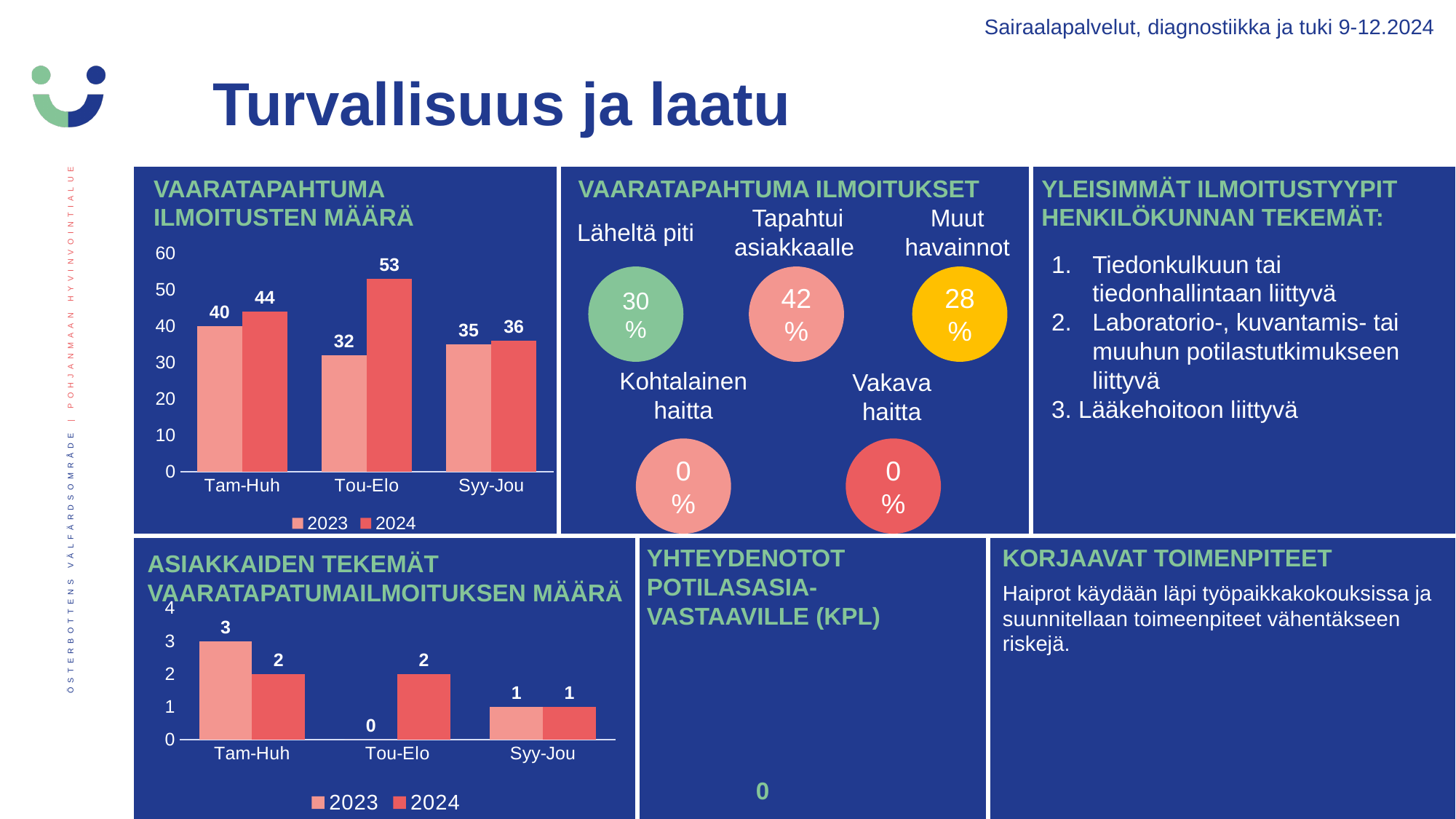
In the chart titled VAARATAPAHTUMA ILMOITUSTEN MÄÄRÄ, which is larger in Tam-Huh: the 2023 value or the 2024 value? 2024 In the chart titled VAARATAPAHTUMA ILMOITUSTEN MÄÄRÄ, which period has the highest 2024 value? Tou-Elo In the chart titled VAARATAPAHTUMA ILMOITUSTEN MÄÄRÄ, how many series does the legend list? 2 In the chart titled VAARATAPAHTUMA ILMOITUSTEN MÄÄRÄ, what is the value for 2023 in Syy-Jou? 35 In the chart titled VAARATAPAHTUMA ILMOITUSTEN MÄÄRÄ, which period has the lowest 2023 value? Tou-Elo In the chart titled ASIAKKAIDEN TEKEMÄT VAARATAPATUMAILMOITUKSEN MÄÄRÄ, what is the value for 2023 in Tam-Huh? 3 In the chart titled ASIAKKAIDEN TEKEMÄT VAARATAPATUMAILMOITUKSEN MÄÄRÄ, how many periods are shown on the x axis? 3 In the chart titled ASIAKKAIDEN TEKEMÄT VAARATAPATUMAILMOITUKSEN MÄÄRÄ, do the 2023 values rise or fall from Tam-Huh to Tou-Elo? Fall In the chart titled ASIAKKAIDEN TEKEMÄT VAARATAPATUMAILMOITUKSEN MÄÄRÄ, what is the value for 2023 in Tou-Elo? 0 What kind of chart is the chart titled VAARATAPAHTUMA ILMOITUSTEN MÄÄRÄ? Bar chart In the chart titled VAARATAPAHTUMA ILMOITUSTEN MÄÄRÄ, what is the value for 2024 in Tou-Elo? 53 In the chart titled VAARATAPAHTUMA ILMOITUSTEN MÄÄRÄ, what is the difference between the 2024 and 2023 values in Tou-Elo? 21